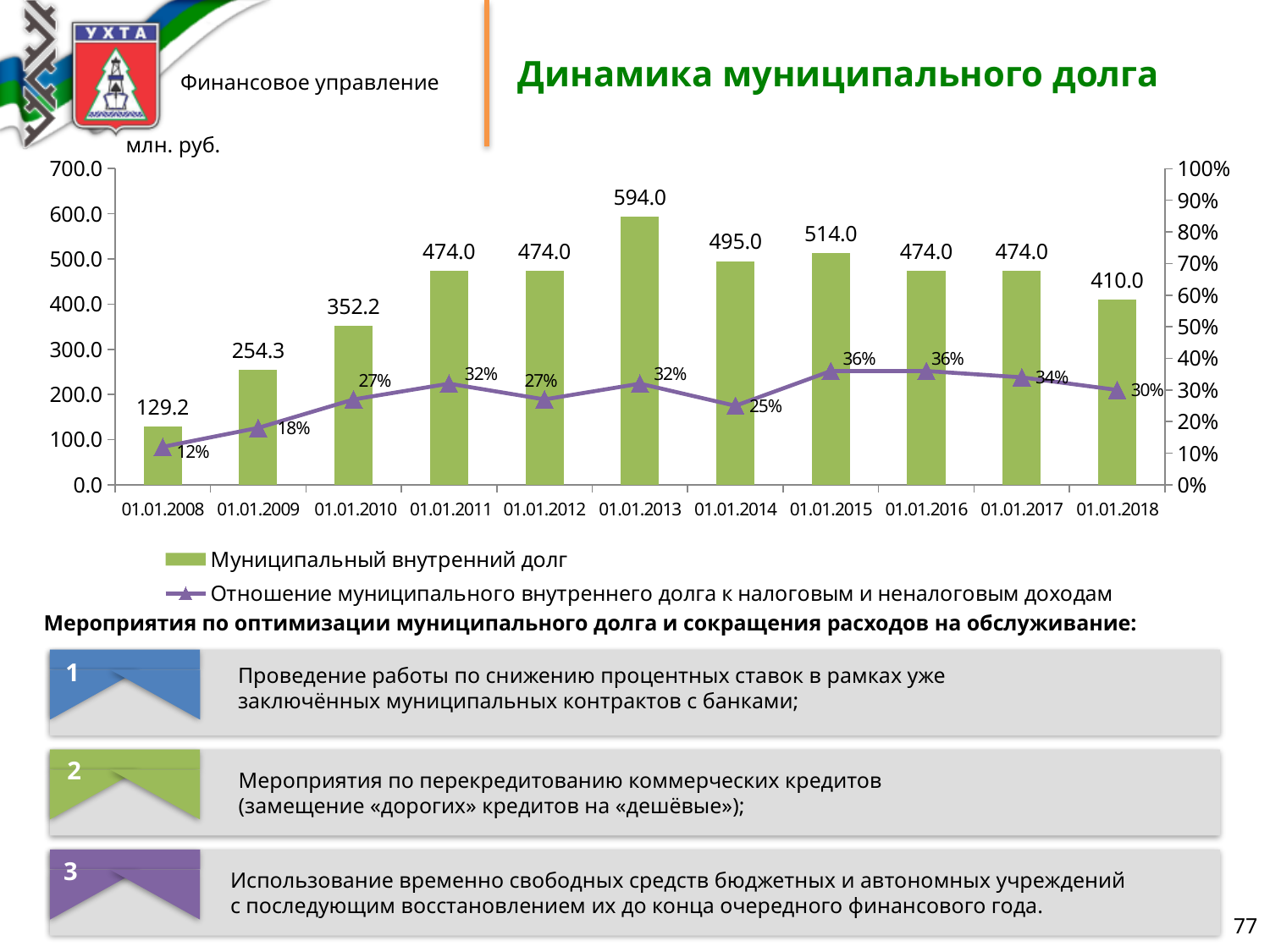
On which date is Муниципальный внутренний долг highest? 01.01.2013 What kind of chart is shown on the slide? Combined bar and line chart What is the value of Муниципальный внутренний долг on 01.01.2018? 410.0 How many series does the legend list? 2 What is the value of Муниципальный внутренний долг on 01.01.2013? 594.0 Which is larger: Муниципальный внутренний долг on 01.01.2015 or on 01.01.2014? 01.01.2015 What is the value of Муниципальный внутренний долг on 01.01.2008? 129.2 On which date is Муниципальный внутренний долг lowest? 01.01.2008 How many dates are shown on the x axis of the chart? 11 What is the ratio of municipal internal debt to tax and non-tax revenues (Отношение муниципального внутреннего долга к налоговым и неналоговым доходам) on 01.01.2015? 36% What is the title of the chart? Динамика муниципального долга What is the difference between Муниципальный внутренний долг on 01.01.2013 and on 01.01.2014? 99.0